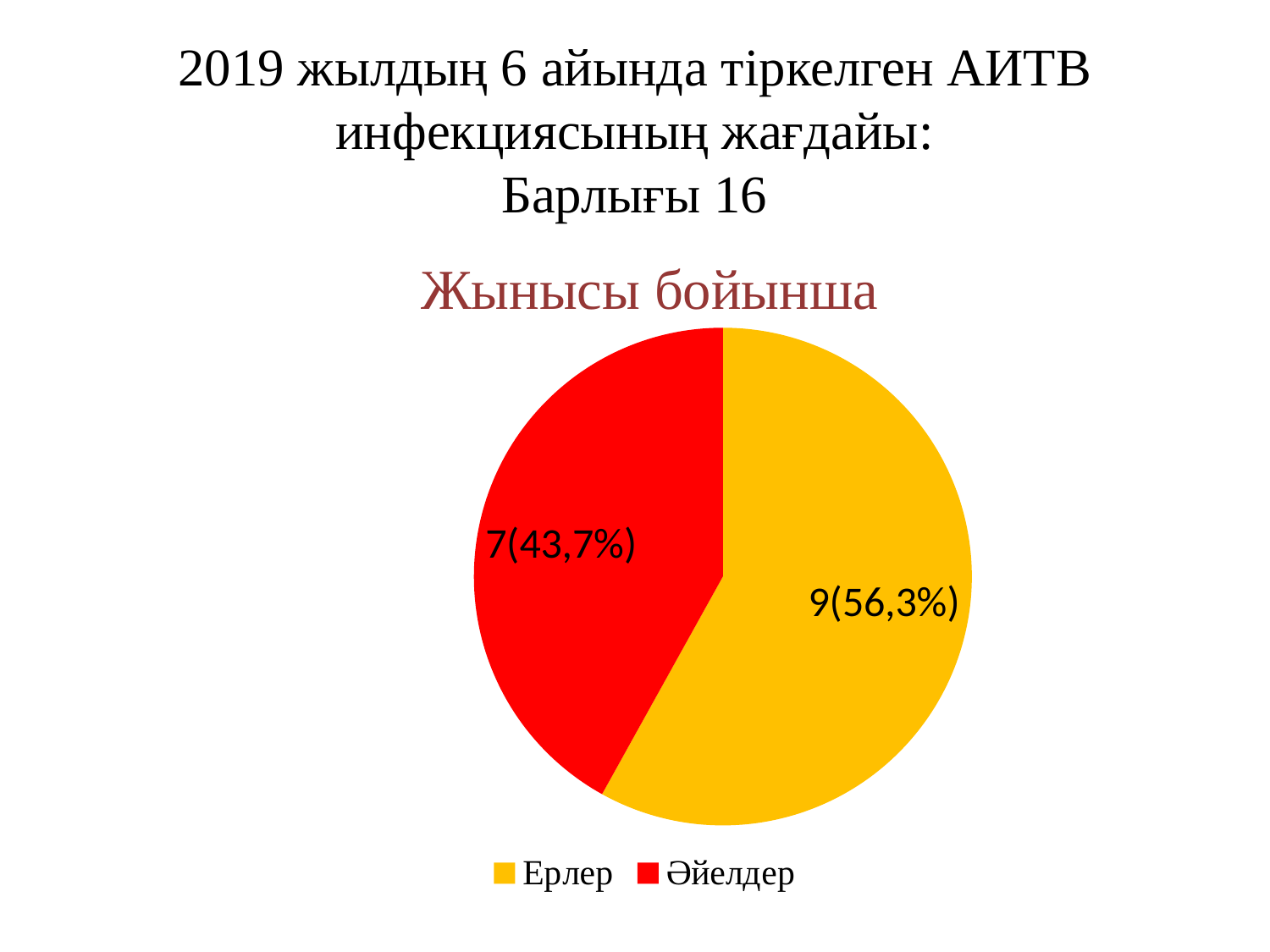
Which category has the largest slice of the pie? Ерлер What is the data label shown on the Ерлер slice? 9(56,3%) What is the title of the chart? Жынысы бойынша What share of the pie does the Ерлер slice represent? 56,3% What is the data label shown on the Әйелдер slice? 7(43,7%) Which category has the smallest slice of the pie? Әйелдер What share of the pie does the Әйелдер slice represent? 43,7% How many categories does the legend list? 2 What is the difference between the count for Ерлер and the count for Әйелдер? 2 Which is larger, the count for Ерлер or the count for Әйелдер? Ерлер What colour is the Әйелдер slice? red What kind of chart is shown on the slide? pie chart